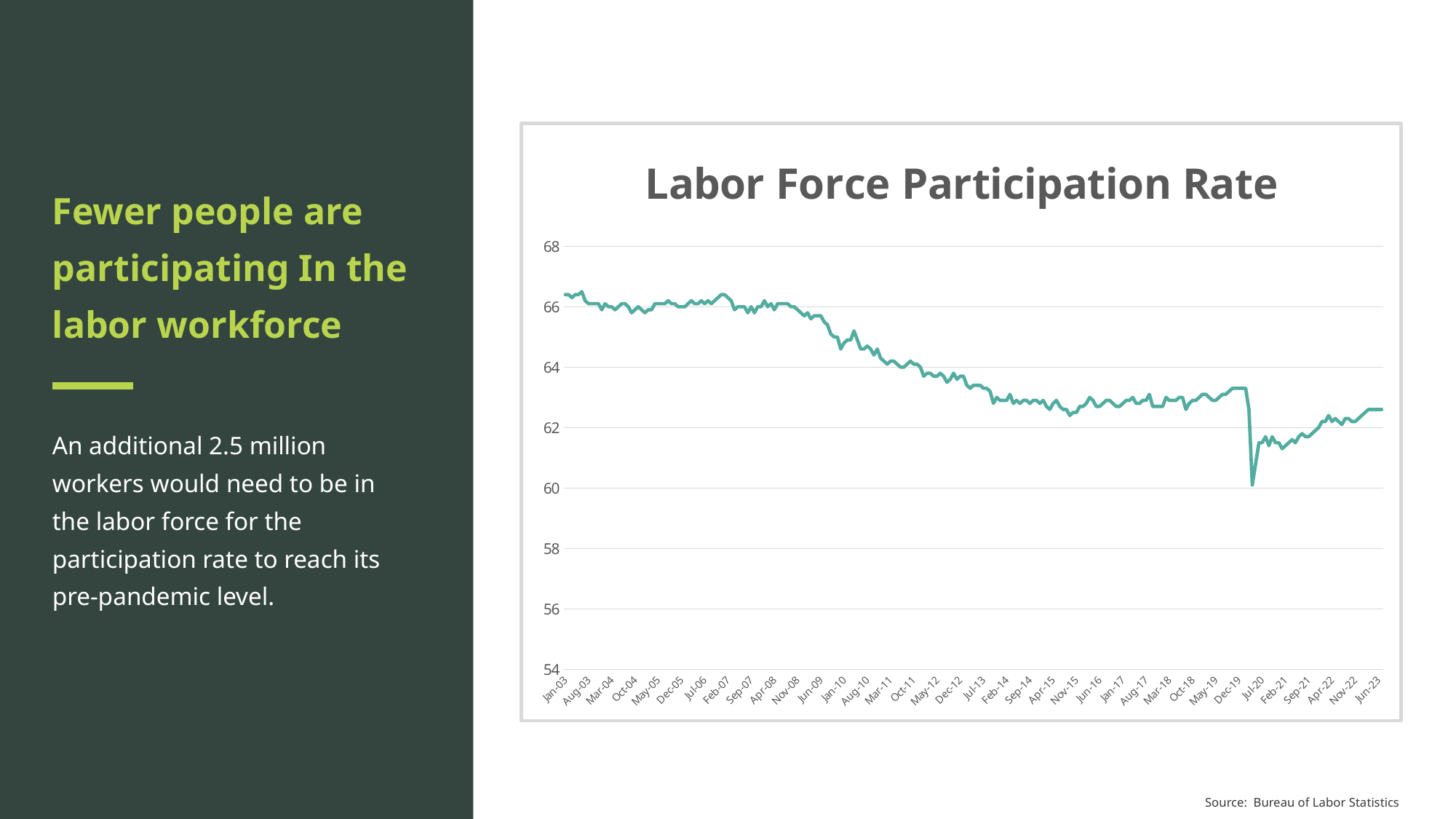
What source is cited for the chart? Bureau of Labor Statistics Is the value for Dec-19 greater or less than 62? greater Is the lowest point on the line greater or less than 62? less Overall, does the labor force participation rate rise or fall from Jan-03 to Jun-23? fall How many data series are plotted in the chart? 1 Is the value for Jan-03 greater or less than 64? greater What is the title of the chart? Labor Force Participation Rate What kind of chart is shown on the slide? line chart Between which two labeled dates on the x axis does the sharpest drop in the line occur? Dec-19 and Jul-20 Does the labor force participation rate rise or fall from Jul-20 to Jun-23? rise